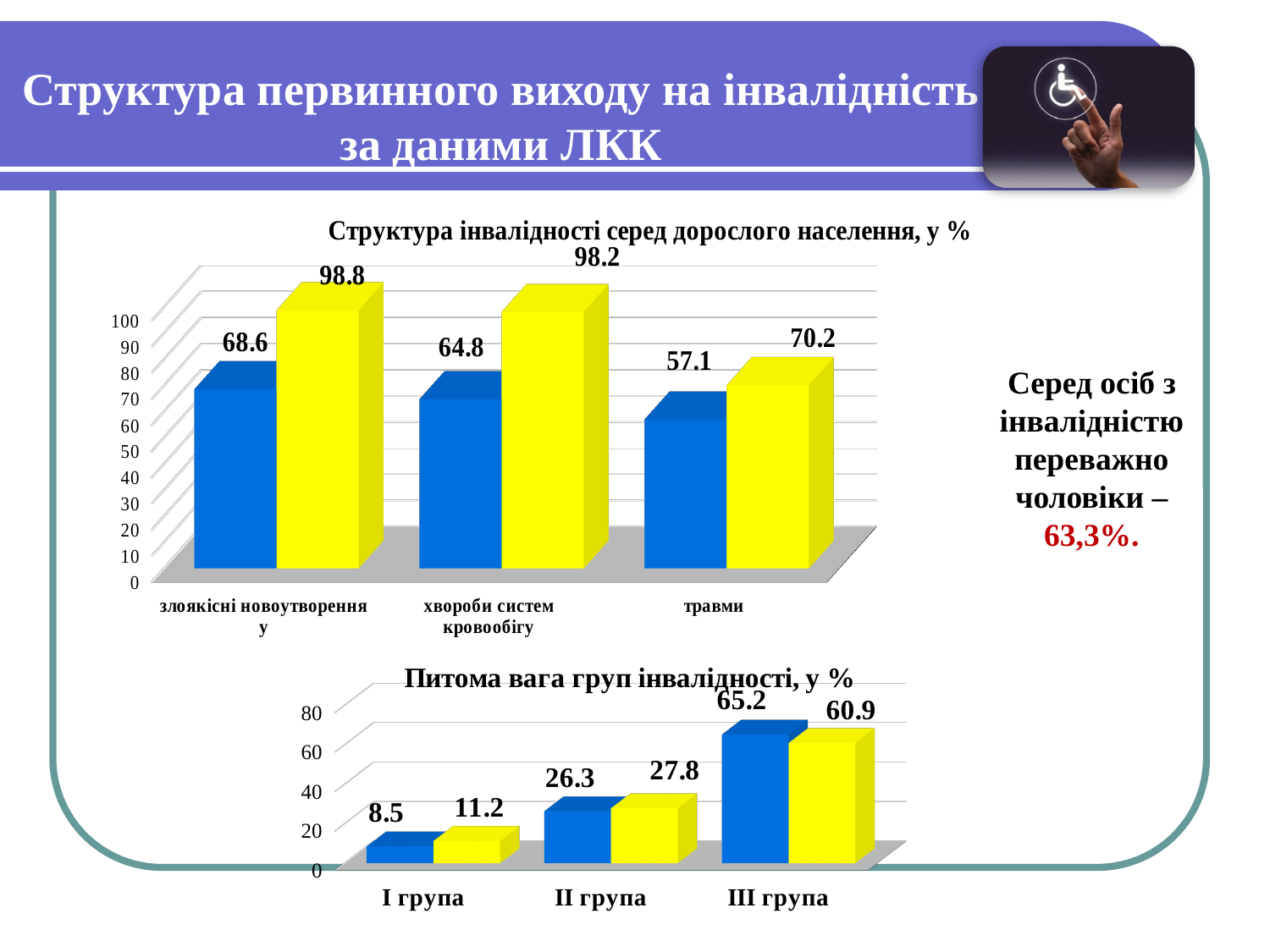
In the bottom chart 'Питома вага груп інвалідності, у %', which is larger for 'III група', the blue bar or the yellow bar? the blue bar In the top chart 'Структура інвалідності серед дорослого населення, у %', what is the difference between the yellow and blue bars for 'травми'? 13.1 What kind of chart is the bottom chart 'Питома вага груп інвалідності, у %'? bar chart In the bottom chart 'Питома вага груп інвалідності, у %', what is the difference between the blue bars for 'III група' and 'I група'? 56.7 What is the title of the top chart on the slide? Структура інвалідності серед дорослого населення, у % In the top chart 'Структура інвалідності серед дорослого населення, у %', do the blue bar values rise or fall from left to right? fall In the top chart 'Структура інвалідності серед дорослого населення, у %', how many categories are shown on the x axis? 3 In the top chart 'Структура інвалідності серед дорослого населення, у %', what is the value of the yellow bar for 'хвороби систем кровообігу'? 98.2 In the bottom chart 'Питома вага груп інвалідності, у %', what is the value of the yellow bar for 'II група'? 27.8 In the bottom chart 'Питома вага груп інвалідності, у %', which group has the highest blue bar? III група In the top chart 'Структура інвалідності серед дорослого населення, у %', what is the value of the blue bar for 'злоякісні новоутворення'? 68.6 In the top chart 'Структура інвалідності серед дорослого населення, у %', which category has the lowest blue bar? травми